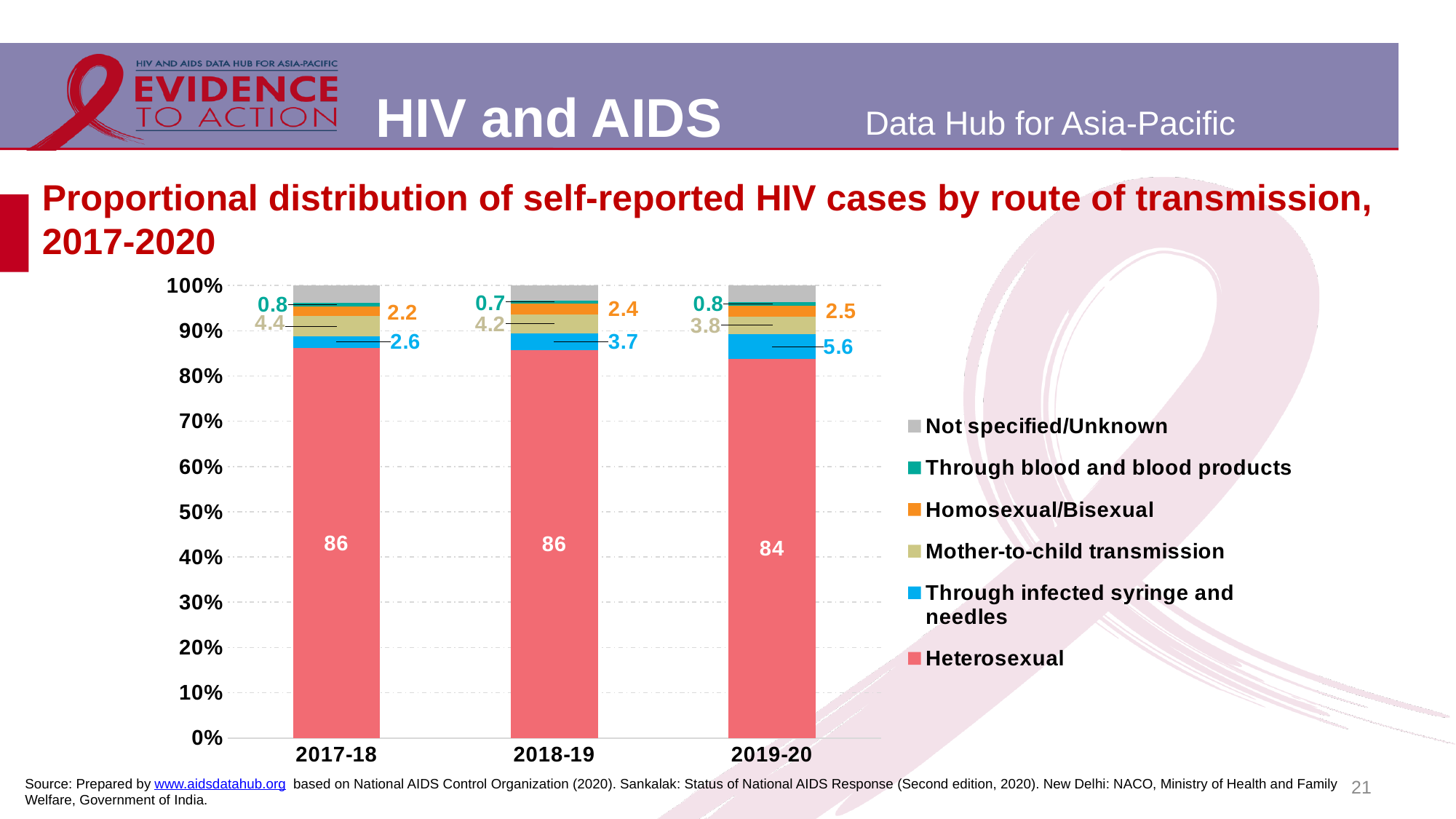
What is the value for Homosexual/Bisexual in 2019-20? 2.5 What is the value for Heterosexual in 2019-20? 84 In which year is the value for Through infected syringe and needles highest? 2019-20 How many year categories are shown on the x axis? 3 How many series does the legend list? 6 What is the value for Through blood and blood products in 2018-19? 0.7 What is the value for Through infected syringe and needles in 2018-19? 3.7 What type of chart is shown on the slide? Stacked bar chart What is the difference between the Through infected syringe and needles values for 2019-20 and 2017-18? 3 What is the value for Mother-to-child transmission in 2017-18? 4.4 In which year is the value for Mother-to-child transmission lowest? 2019-20 Does the value for Through infected syringe and needles rise or fall from 2017-18 to 2019-20? Rise